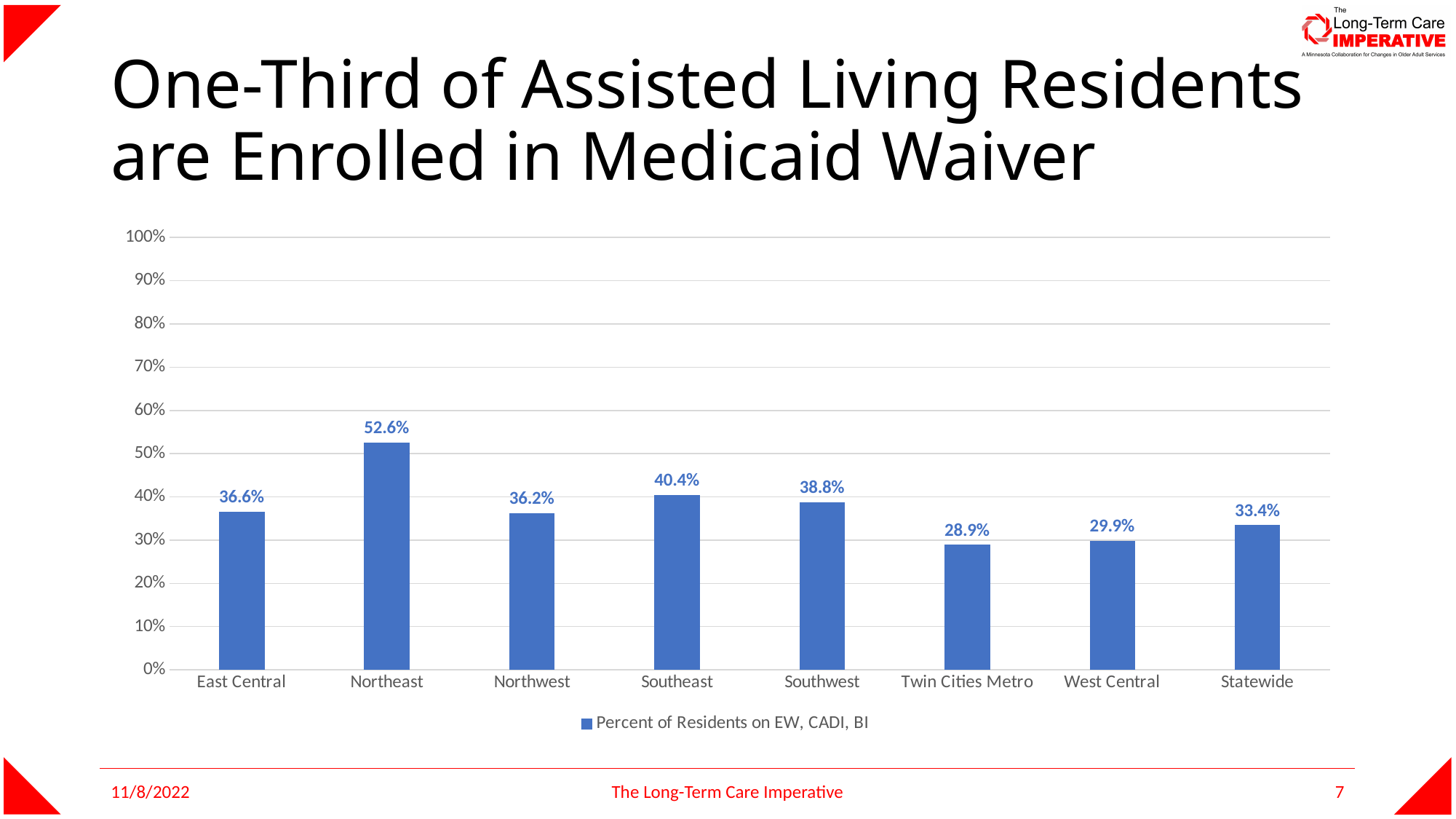
How many series does the legend list? 1 What is the difference between the Northeast and Statewide percentages? 19.2% Is the value for West Central greater or less than 40%? less Which region has the lowest percent of residents on EW, CADI, BI? Twin Cities Metro How many categories are shown on the x axis? 8 What kind of chart is shown on the slide? bar chart Which region has the highest percent of residents on EW, CADI, BI? Northeast What is the legend entry for the series shown? Percent of Residents on EW, CADI, BI Which is larger, the value for Southeast or the value for Southwest? Southeast What is the Statewide percent of residents on EW, CADI, BI? 33.4% What is the percent of residents on EW, CADI, BI for Northeast? 52.6% What is the percent of residents on EW, CADI, BI for Twin Cities Metro? 28.9%